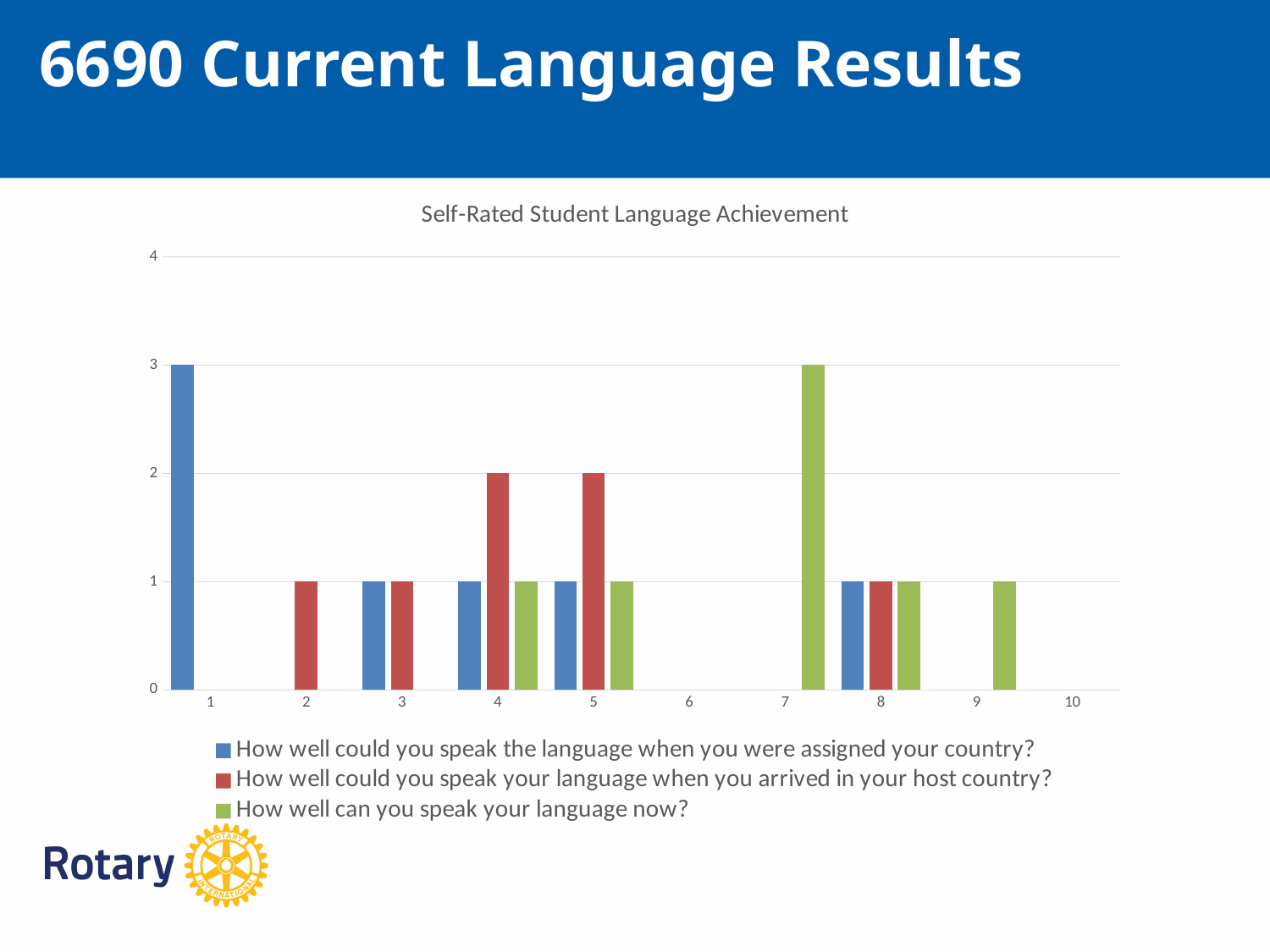
What colour represents the series "How well can you speak your language now?"? green What is the title of the chart? Self-Rated Student Language Achievement What is the value for category 4 in the series "How well could you speak your language when you arrived in your host country?"? 2 Which category has the highest value in the series "How well can you speak your language now?"? 7 What is the value for category 1 in the series "How well could you speak the language when you were assigned your country?"? 3 What is the value for category 7 in the series "How well can you speak your language now?"? 3 For category 4, which is larger: the "arrived in your host country" series or the "speak your language now" series? How well could you speak your language when you arrived in your host country? Which category has the highest value in the series "How well could you speak the language when you were assigned your country?"? 1 What is the difference between the value for category 5 in the "arrived in your host country" series and the value for category 5 in the "assigned your country" series? 1 What type of chart is shown on the slide? bar chart How many series does the legend list? 3 How many categories are shown on the x axis? 10